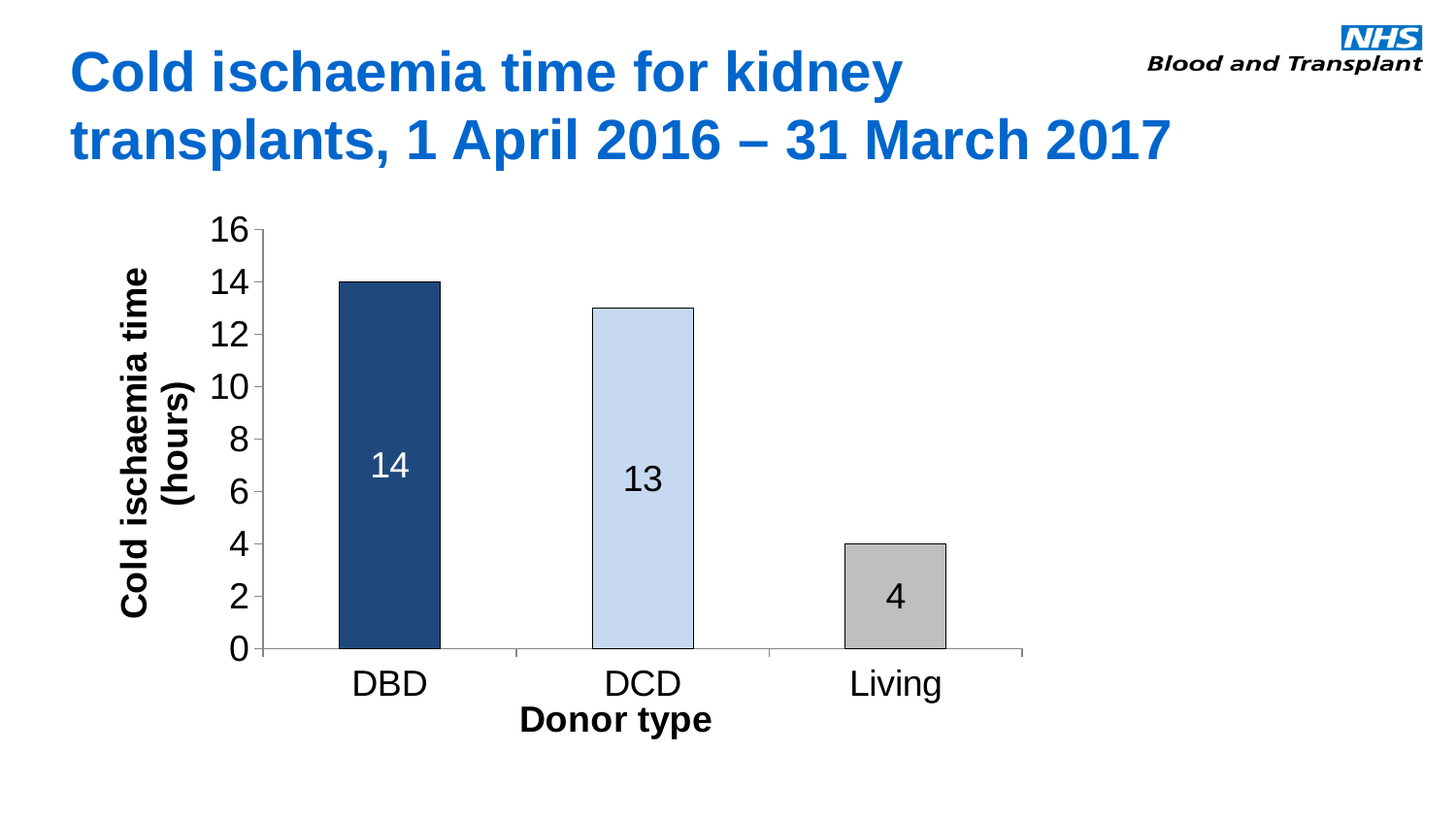
What is the cold ischaemia time for DBD donors? 14 What is the cold ischaemia time for Living donors? 4 What is the label of the y axis? Cold ischaemia time (hours) Which donor type has the lowest cold ischaemia time? Living What is the cold ischaemia time for DCD donors? 13 Which has a larger cold ischaemia time, DCD or Living? DCD What kind of chart is shown on the slide? Bar chart Is the value for Living greater or less than 6? less How many donor types are shown on the chart? 3 What is the difference in cold ischaemia time between DBD and Living donors? 10 What is the difference in cold ischaemia time between DBD and DCD donors? 1 Which donor type has the highest cold ischaemia time? DBD